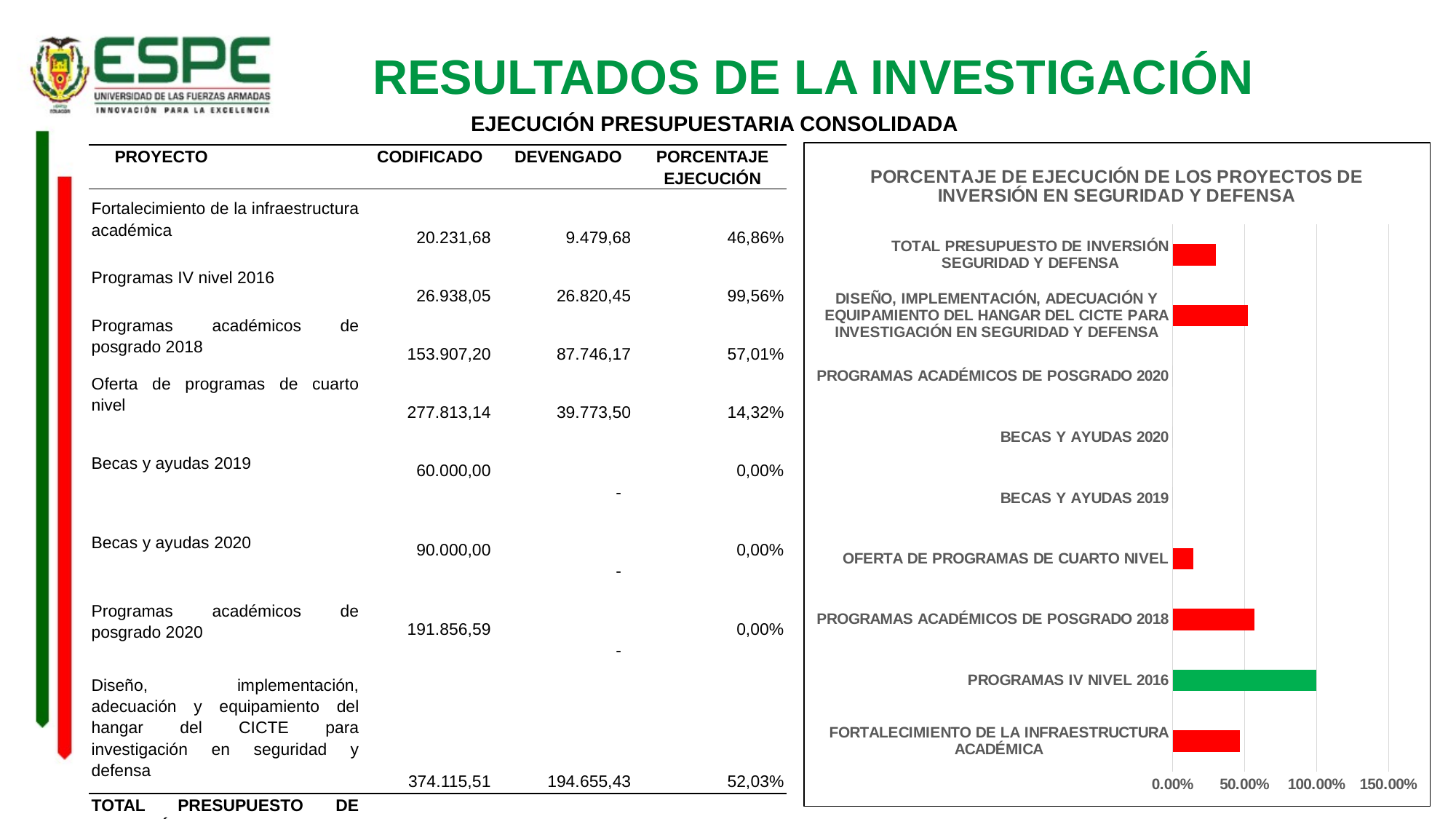
What kind of chart is shown on the right side of the slide? bar chart Is the value for OFERTA DE PROGRAMAS DE CUARTO NIVEL greater or less than 50.00%? less What colour is the bar for PROGRAMAS IV NIVEL 2016 in the chart? green How many categories in the chart show no visible bar? 3 Is the value for PROGRAMAS ACADÉMICOS DE POSGRADO 2018 greater or less than 100.00%? less What is the title of the chart on the right side of the slide? PORCENTAJE DE EJECUCIÓN DE LOS PROYECTOS DE INVERSIÓN EN SEGURIDAD Y DEFENSA Is the value for PROGRAMAS IV NIVEL 2016 greater or less than 50.00%? greater How many categories are listed on the vertical axis of the chart? 9 Which is larger in the chart: PROGRAMAS IV NIVEL 2016 or OFERTA DE PROGRAMAS DE CUARTO NIVEL? PROGRAMAS IV NIVEL 2016 Which is larger in the chart: PROGRAMAS ACADÉMICOS DE POSGRADO 2018 or FORTALECIMIENTO DE LA INFRAESTRUCTURA ACADÉMICA? PROGRAMAS ACADÉMICOS DE POSGRADO 2018 Which category has the longest bar in the chart? PROGRAMAS IV NIVEL 2016 What is the highest tick value shown on the horizontal axis of the chart? 150.00%